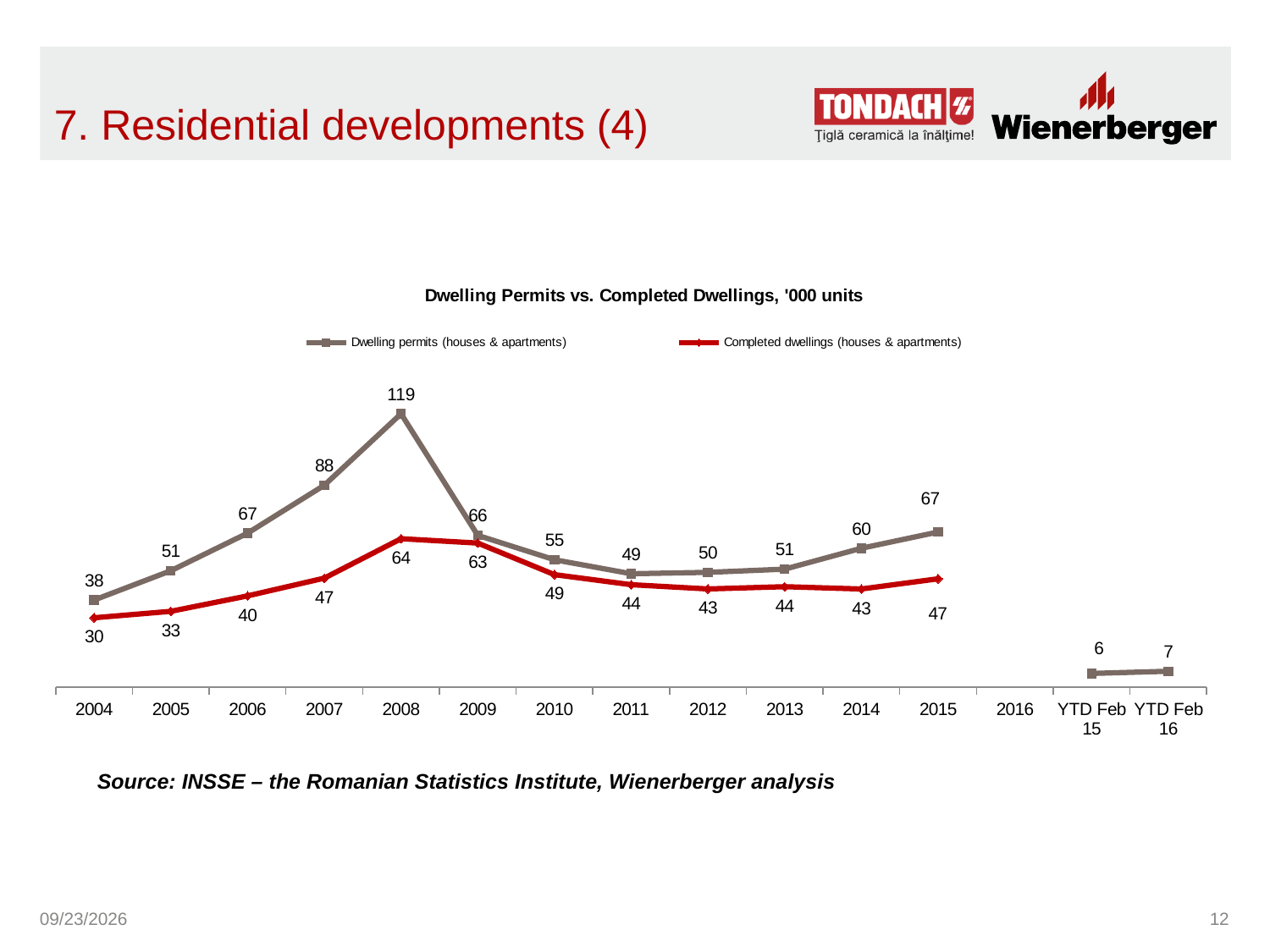
What is the title of the chart? Dwelling Permits vs. Completed Dwellings, '000 units In 2015, which series has the larger value: dwelling permits or completed dwellings? Dwelling permits Do dwelling permits rise or fall from 2004 to 2008? Rise What is the value of completed dwellings (houses & apartments) in 2009? 63 How many series does the legend list? 2 What kind of chart is shown on the slide? Line chart In which year were dwelling permits highest? 2008 What is the value of dwelling permits for YTD Feb 16? 7 What is the difference between dwelling permits and completed dwellings in 2008? 55 What is the value of dwelling permits (houses & apartments) in 2008? 119 In which year were completed dwellings lowest? 2004 By how much did dwelling permits increase from 2014 to 2015? 7